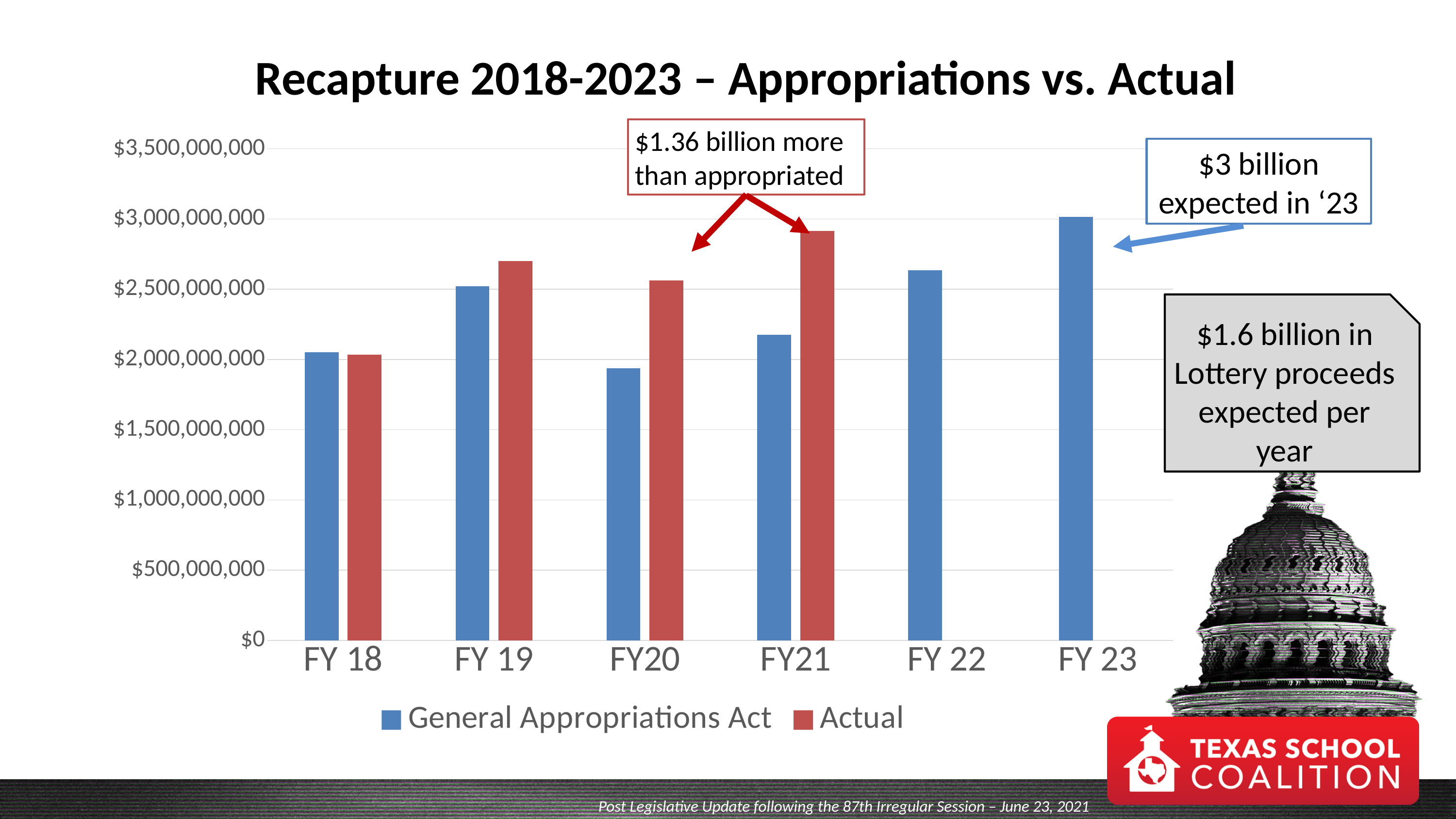
Do the General Appropriations Act values rise or fall from FY21 to FY 23? rise Is the General Appropriations Act value for FY20 greater or less than $2,000,000,000? less What kind of chart is shown on the slide? bar chart For FY20, which is larger: the General Appropriations Act value or the Actual value? Actual Which fiscal year has the lowest Actual bar? FY 18 What is the title of the chart? Recapture 2018-2023 – Appropriations vs. Actual Is the Actual value for FY21 greater or less than $2,500,000,000? greater Which fiscal year has the highest Actual bar? FY21 How many series does the legend list? 2 Which fiscal year has the highest General Appropriations Act bar? FY 23 How many fiscal year categories are shown on the x axis? 6 Which fiscal year has the lowest General Appropriations Act bar? FY20